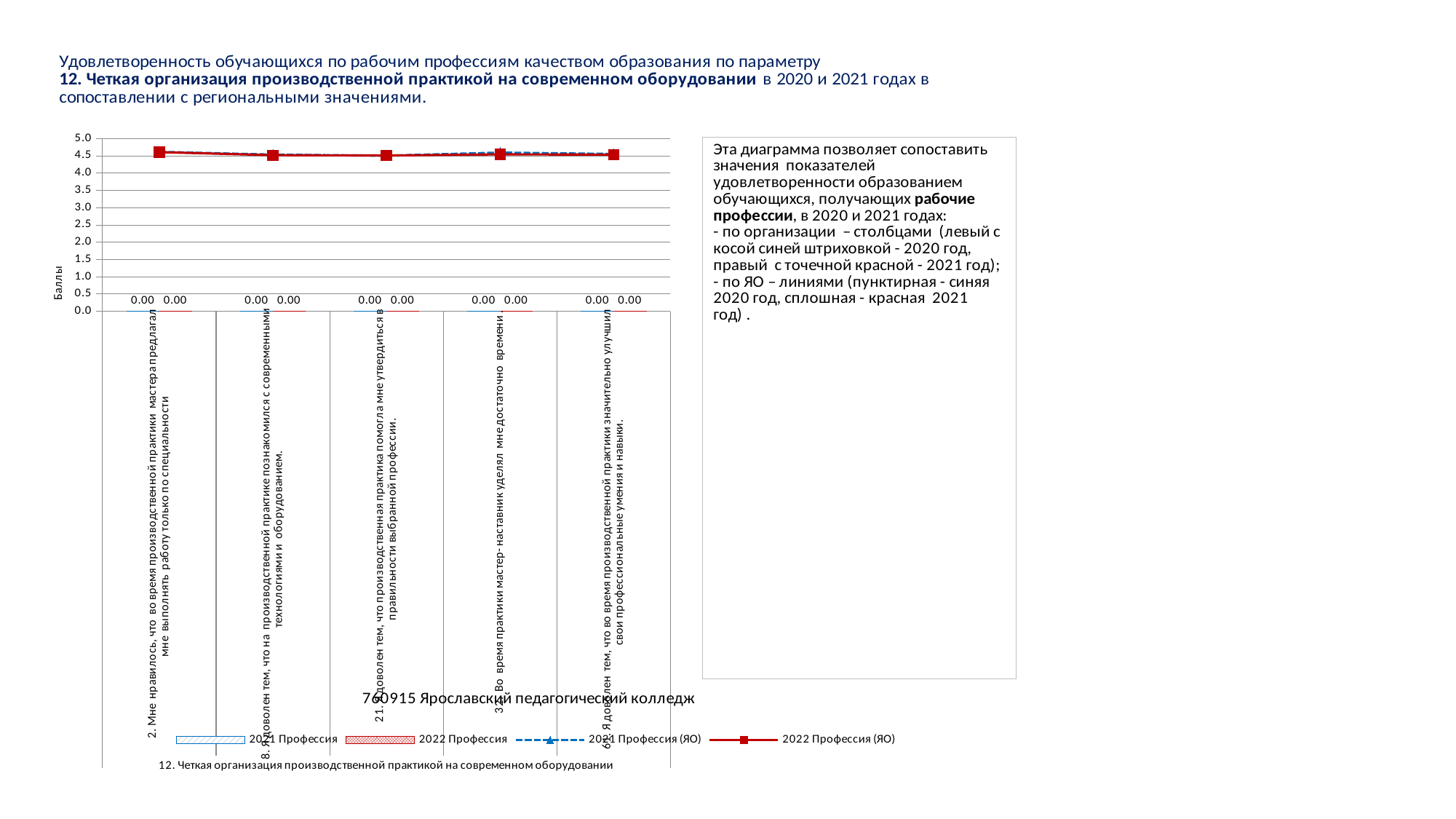
What is the title of the vertical axis of the chart? Баллы How many categories are shown along the x axis of the chart? 5 Is the value of '2021 Профессия (ЯО)' for the category '21. Я доволен тем, что производственная практика помогла мне утвердиться в правильности выбранной профессии' greater or less than 5.0? less What is the value of '2022 Профессия' for the category '3. Во время практики мастер-наставник уделял мне достаточно времени'? 0.00 Is the value of '2022 Профессия (ЯО)' for the category '2. Мне нравилось, что во время производственной практики мастер предлагал мне выполнять работу только по специальности' greater or less than 4.0? greater What kind of chart is used for the '2022 Профессия (ЯО)' series? line chart What is the value of '2022 Профессия' for the category '6. Я доволен тем, что во время производственной практики значительно улучшил свои профессиональные умения и навыки'? 0.00 What is the value of '2021 Профессия' for the category '2. Мне нравилось, что во время производственной практики мастер предлагал мне выполнять работу только по специальности'? 0.00 For the category '8. Я доволен тем, что на производственной практике познакомился с современными технологиями и оборудованием', which is larger: the value of '2022 Профессия' or the value of '2022 Профессия (ЯО)'? 2022 Профессия (ЯО) How many series does the chart legend list? 4 What kind of chart is used for the '2021 Профессия' series? bar chart